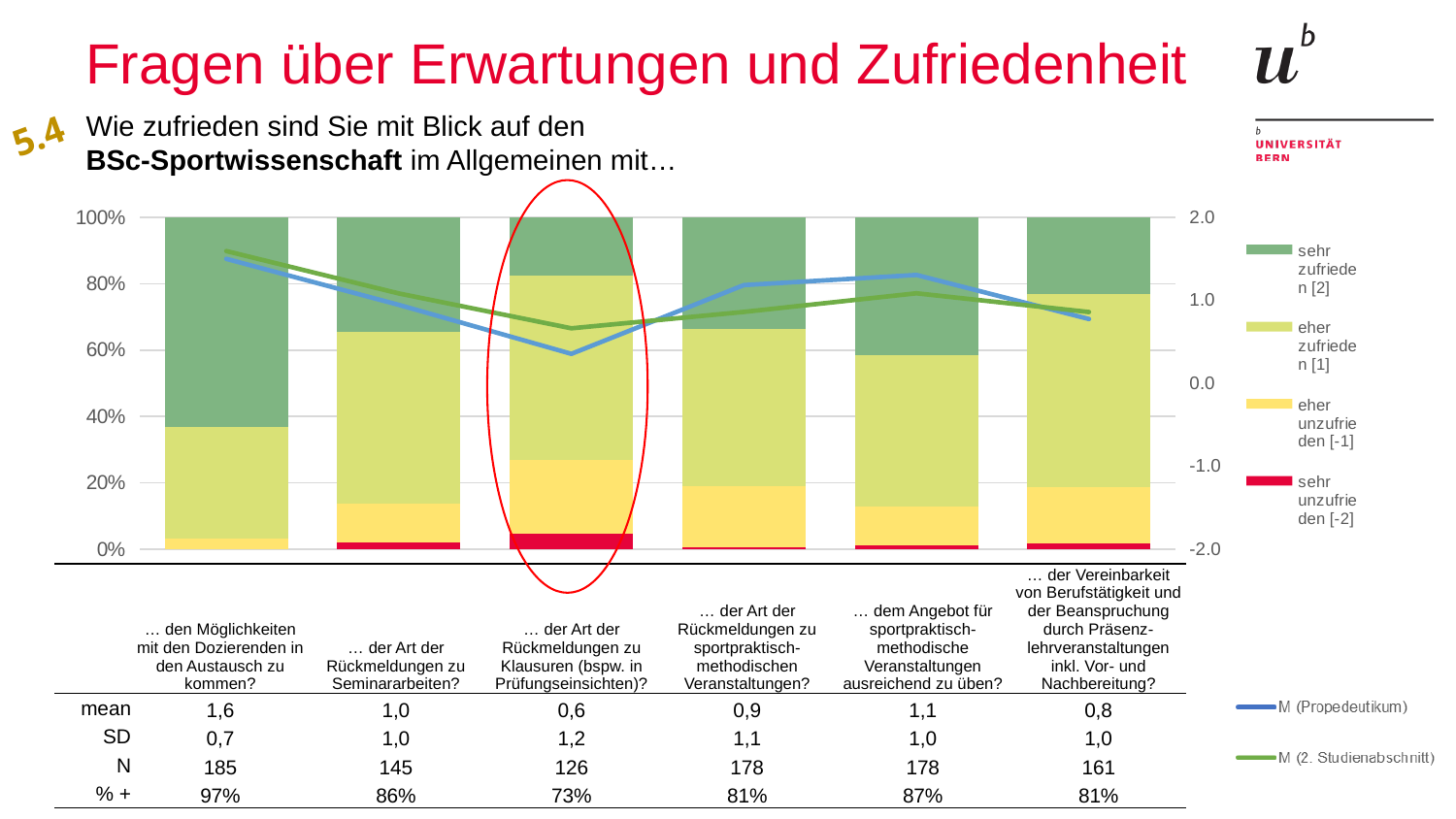
What kind of chart is shown on the slide? a combination of a 100% stacked bar chart and a line chart What is the N value for '… der Vereinbarkeit von Berufstätigkeit und der Beanspruchung durch Präsenzlehrveranstaltungen inkl. Vor- und Nachbereitung?' 161 Which category has the lowest '% +' value? … der Art der Rückmeldungen zu Klausuren (bspw. in Prüfungseinsichten)? What colour represents 'sehr unzufrieden [-2]' in the chart? red Which has the higher '% +' value: '… der Art der Rückmeldungen zu Seminararbeiten?' or '… dem Angebot für sportpraktisch-methodische Veranstaltungen ausreichend zu üben?' … dem Angebot für sportpraktisch-methodische Veranstaltungen ausreichend zu üben? What is the SD value for '… der Art der Rückmeldungen zu Klausuren (bspw. in Prüfungseinsichten)?' 1,2 What is the mean value shown for '… der Art der Rückmeldungen zu Klausuren (bspw. in Prüfungseinsichten)?' 0,6 Is the 'eher zufrieden [1]' share for '… der Art der Rückmeldungen zu Klausuren' greater or less than 40%? greater How many categories (questions) are plotted along the x axis of the chart? 6 How many series does the legend list in total, including the two line series? 6 Which category has the highest mean value in the table below the chart? … den Möglichkeiten mit den Dozierenden in den Austausch zu kommen? What is the difference in N between '… den Möglichkeiten mit den Dozierenden in den Austausch zu kommen?' (185) and '… der Art der Rückmeldungen zu Klausuren' (126)? 59